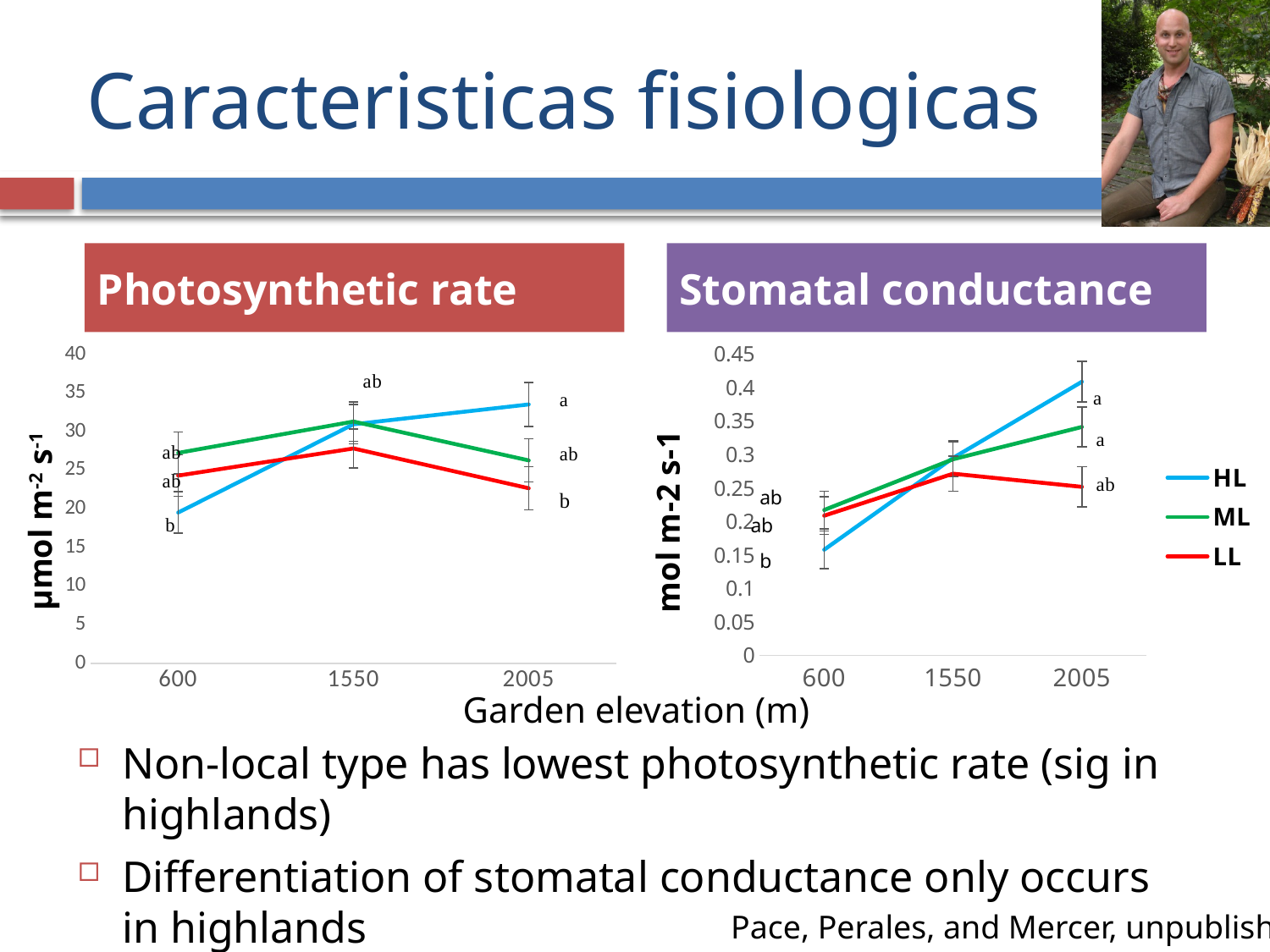
In the Stomatal conductance chart, which series has the lowest value at 600 m? HL In the Stomatal conductance chart, which series has the highest value at 2005 m? HL In the Photosynthetic rate chart, which series has the lowest value at 600 m? HL In the Stomatal conductance chart, is the value for HL at 600 m greater or less than 0.2? less How many series does the legend list for the charts? 3 How many garden elevation points are plotted on the x axis of the Stomatal conductance chart? 3 In the Photosynthetic rate chart, is the value for LL at 2005 m greater or less than 25? less In the Stomatal conductance chart, does the HL series rise or fall as garden elevation increases? rise In the Stomatal conductance chart, which is larger at 2005 m: ML or LL? ML In the Photosynthetic rate chart, is the value for HL at 2005 m greater or less than 30? greater What kind of chart is the Photosynthetic rate chart? line chart In the Photosynthetic rate chart, which series has the highest value at 2005 m? HL